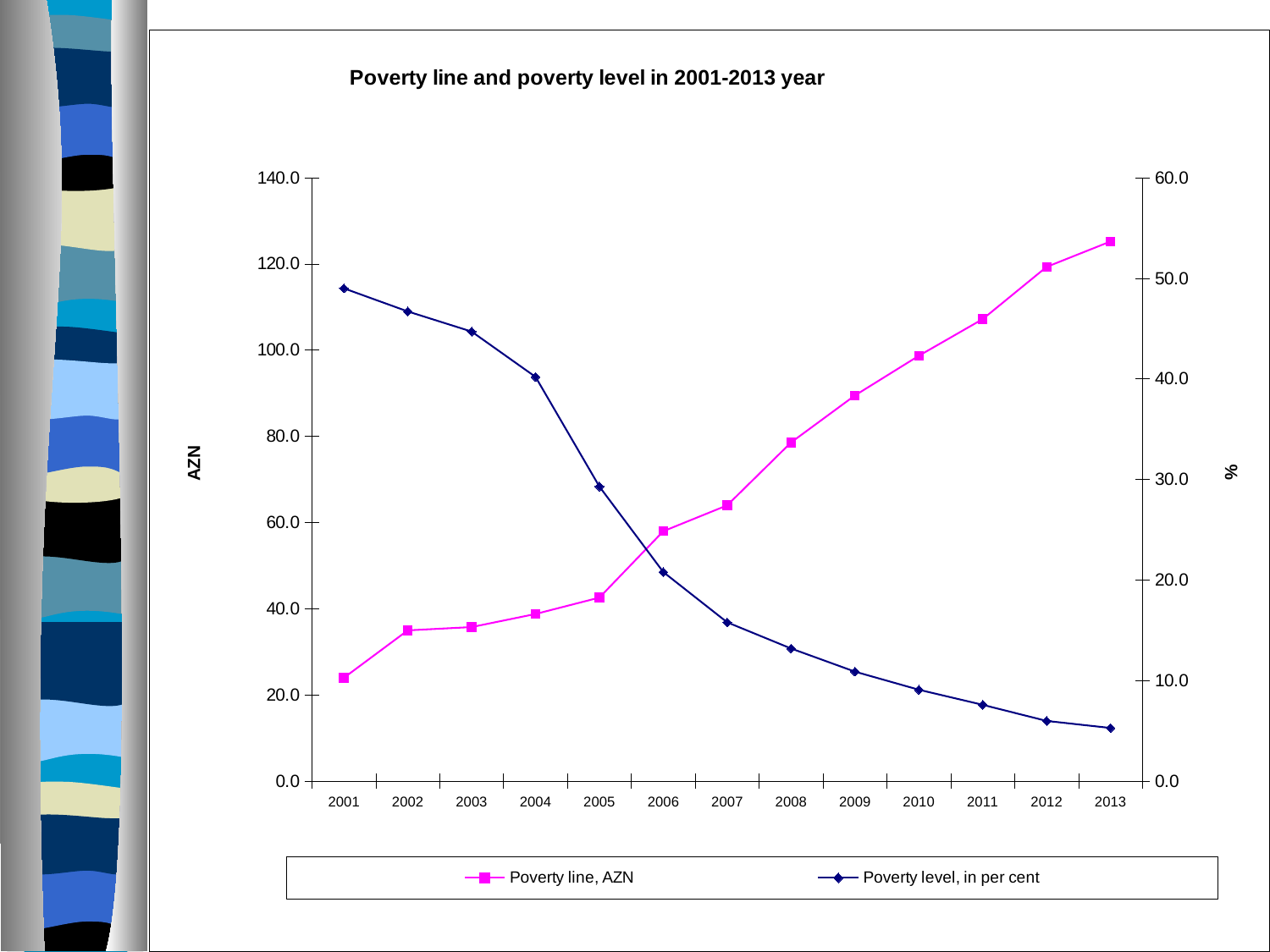
In which year is the Poverty level, in per cent highest? 2001 In which year is the Poverty level, in per cent lowest? 2013 Is the Poverty level, in per cent value for 2006 greater or less than 30.0? less Is the Poverty line, AZN value for 2013 greater or less than 120.0? greater In which year is the Poverty line, AZN highest? 2013 What kind of chart is shown on the slide? Line chart How many series does the legend list? 2 Does the Poverty level, in per cent series rise or fall from 2001 to 2013? Falls What is the title of the chart? Poverty line and poverty level in 2001-2013 year How many years are plotted along the x axis? 13 Is the Poverty line, AZN value for 2001 greater or less than 40.0? less Does the Poverty line, AZN series rise or fall from 2001 to 2013? Rises